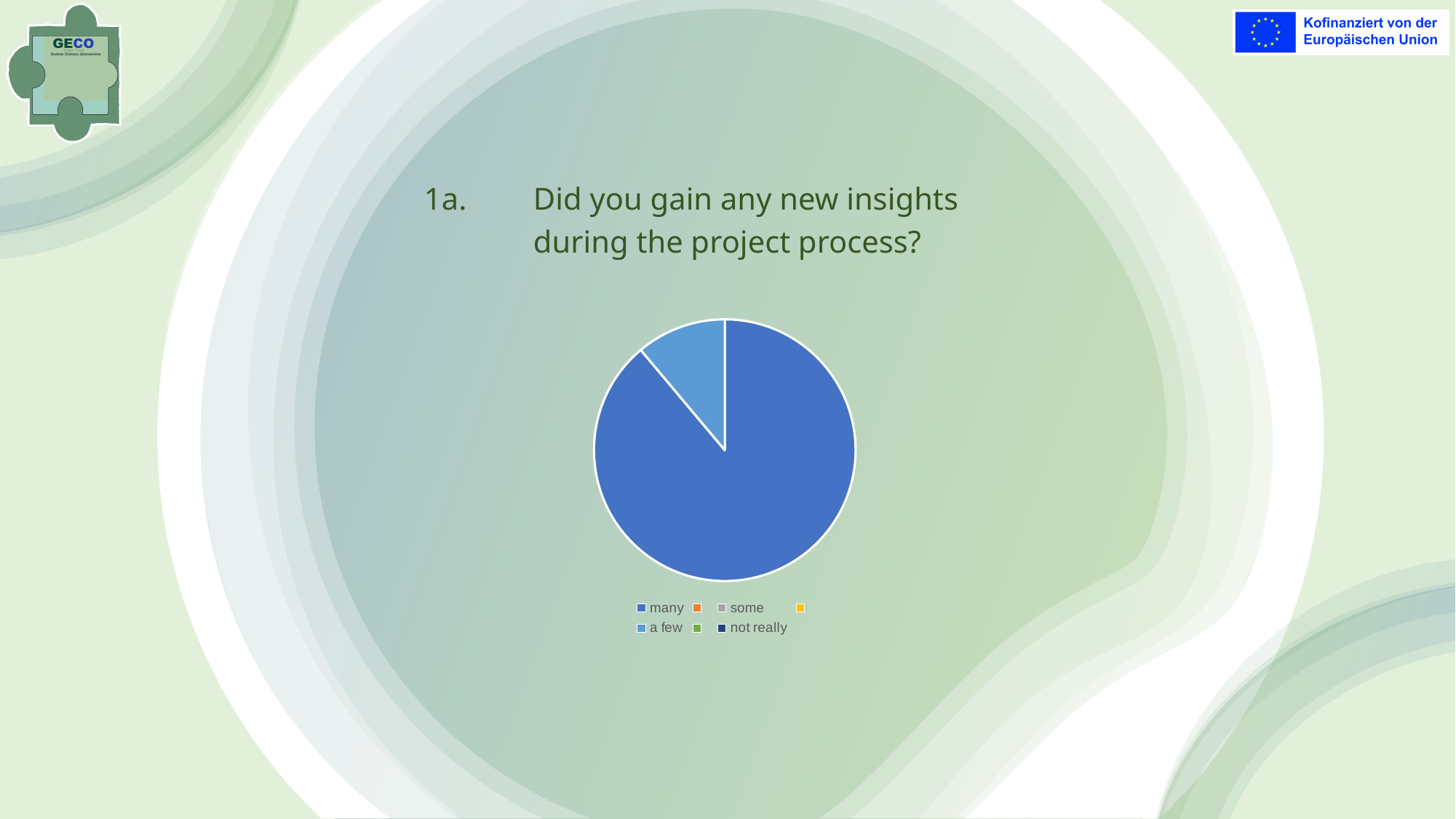
What kind of chart is shown on the slide? pie chart What colour is the slice for "many"? blue Which category has the largest slice of the pie? many Which of the visible slices is the smallest? a few What question does the chart's title ask? Did you gain any new insights during the project process? How many slices are visible in the pie chart? 2 Which slice is larger, "many" or "a few"? many